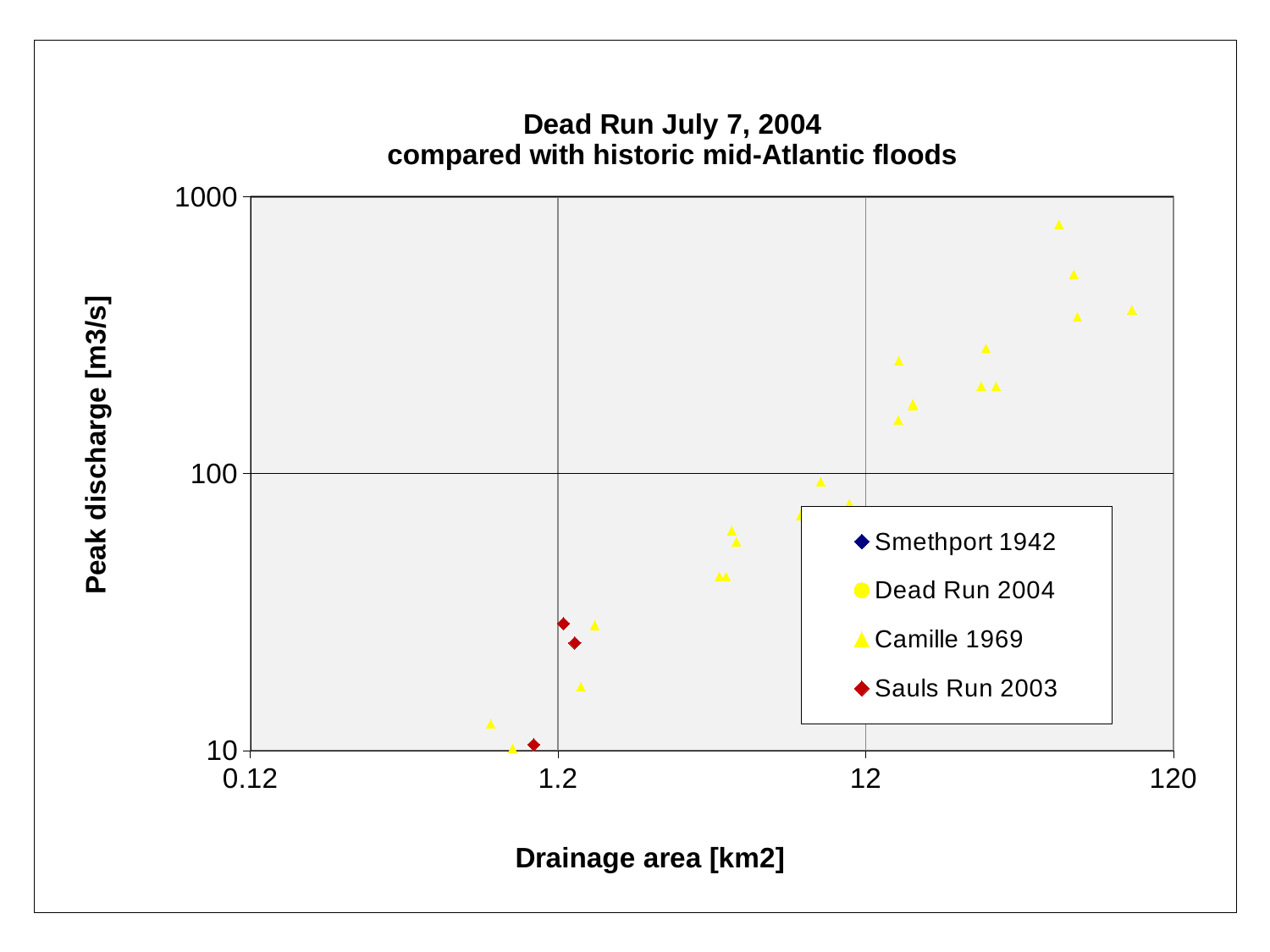
Which series is plotted with red diamond markers? Sauls Run 2003 Do the Camille 1969 peak discharge values generally rise or fall as drainage area increases? rise Is the peak discharge of the highest Camille 1969 point greater or less than 100? greater Are the peak discharge values of the Sauls Run 2003 points greater or less than 100? less Which series has the highest plotted peak discharge, Camille 1969 or Sauls Run 2003? Camille 1969 What is the title of the chart? Dead Run July 7, 2004 compared with historic mid-Atlantic floods How many series does the legend list? 4 What kind of chart is shown on the slide? scatter chart How many Sauls Run 2003 points are plotted on the chart? 3 What is the largest value shown on the x axis? 120 Is the drainage area of the largest Camille 1969 point greater or less than 12? greater